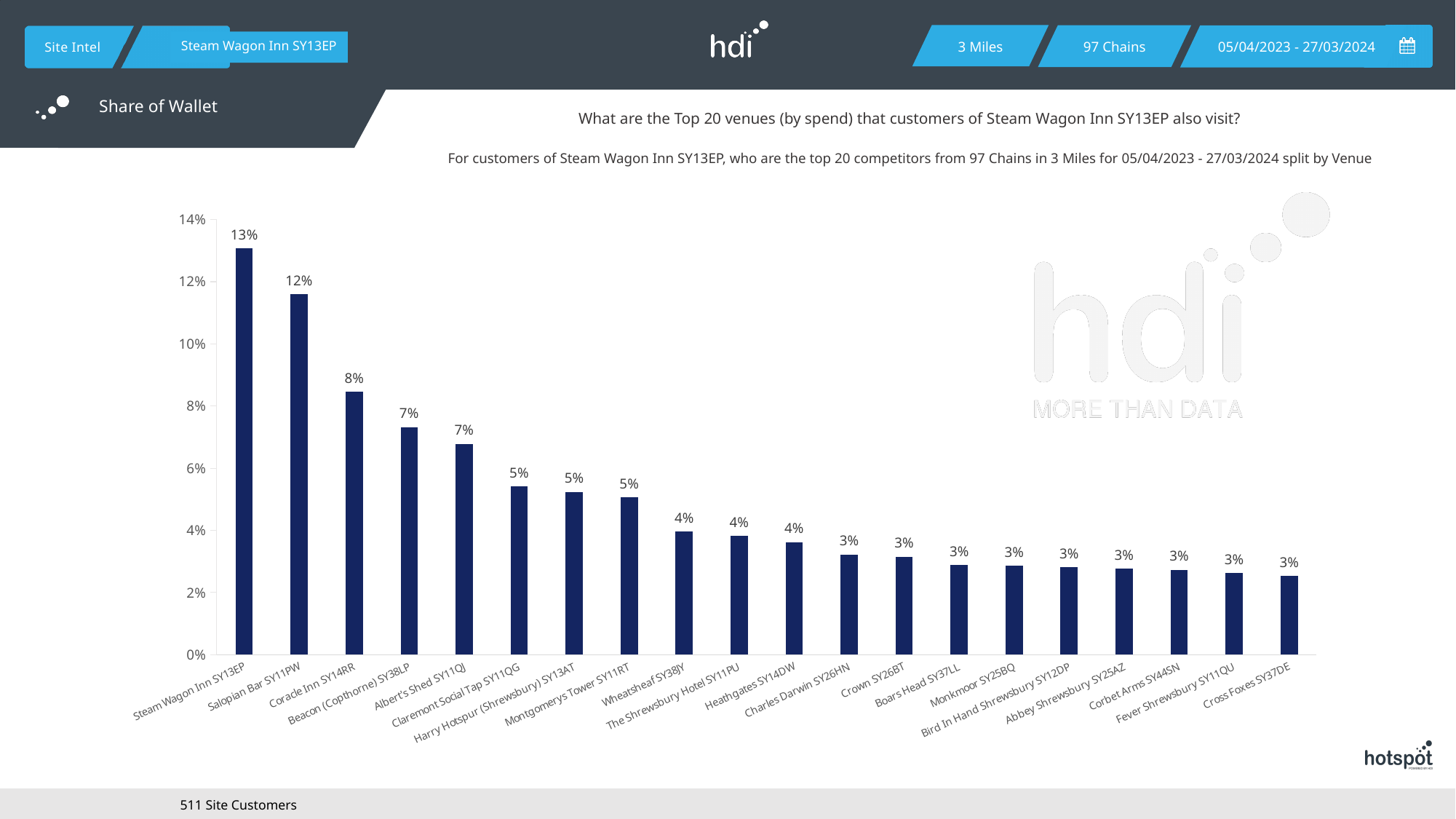
How many venues are shown on the chart? 20 What is the value for Cross Foxes SY37DE? 3% What is the difference between the values for Steam Wagon Inn SY13EP and Coracle Inn SY14RR? 5% Which is larger, the value for Coracle Inn SY14RR or the value for Beacon (Copthorne) SY38LP? Coracle Inn SY14RR What kind of chart is shown on the slide? bar chart What is the value for Wheatsheaf SY38JY? 4% Is the value for Salopian Bar SY11PW greater or less than 10%? greater Which venue has the highest value? Steam Wagon Inn SY13EP What is the difference between the values for Steam Wagon Inn SY13EP and Salopian Bar SY11PW? 1% What is the value for Steam Wagon Inn SY13EP? 13% Do the values rise or fall from left to right along the x axis? fall What is the value for Coracle Inn SY14RR? 8%